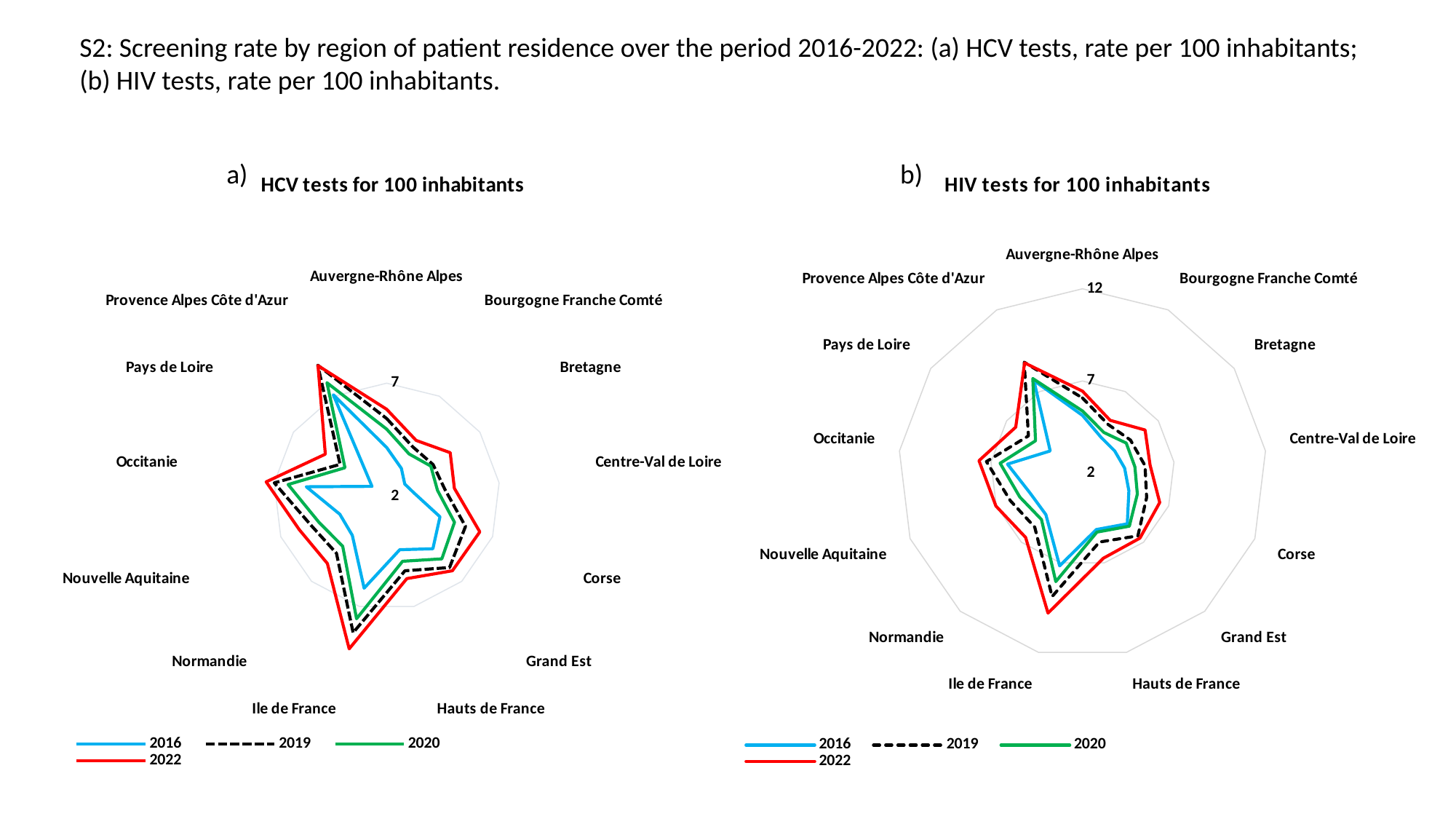
On chart (b), HIV tests for 100 inhabitants, which is larger for Ile de France: the 2016 value or the 2022 value? 2022 On chart (b), HIV tests for 100 inhabitants, is the 2022 value for Occitanie greater or less than 7? greater On chart (b), HIV tests for 100 inhabitants, is the 2016 value for Auvergne-Rhône Alpes greater or less than 7? less How many series does the legend of chart (a), HCV tests for 100 inhabitants, list? 4 On chart (b), HIV tests for 100 inhabitants, what is the value of the outermost labelled axis ring? 12 What kind of chart is chart (a), HCV tests for 100 inhabitants? Radar chart On chart (a), HCV tests for 100 inhabitants, is the 2022 value for Occitanie greater or less than 7? greater On chart (a), HCV tests for 100 inhabitants, which is larger for Occitanie: the 2016 value or the 2022 value? 2022 How many regions are plotted on chart (b), HIV tests for 100 inhabitants? 13 On chart (a), HCV tests for 100 inhabitants, which year is drawn as a dashed black line? 2019